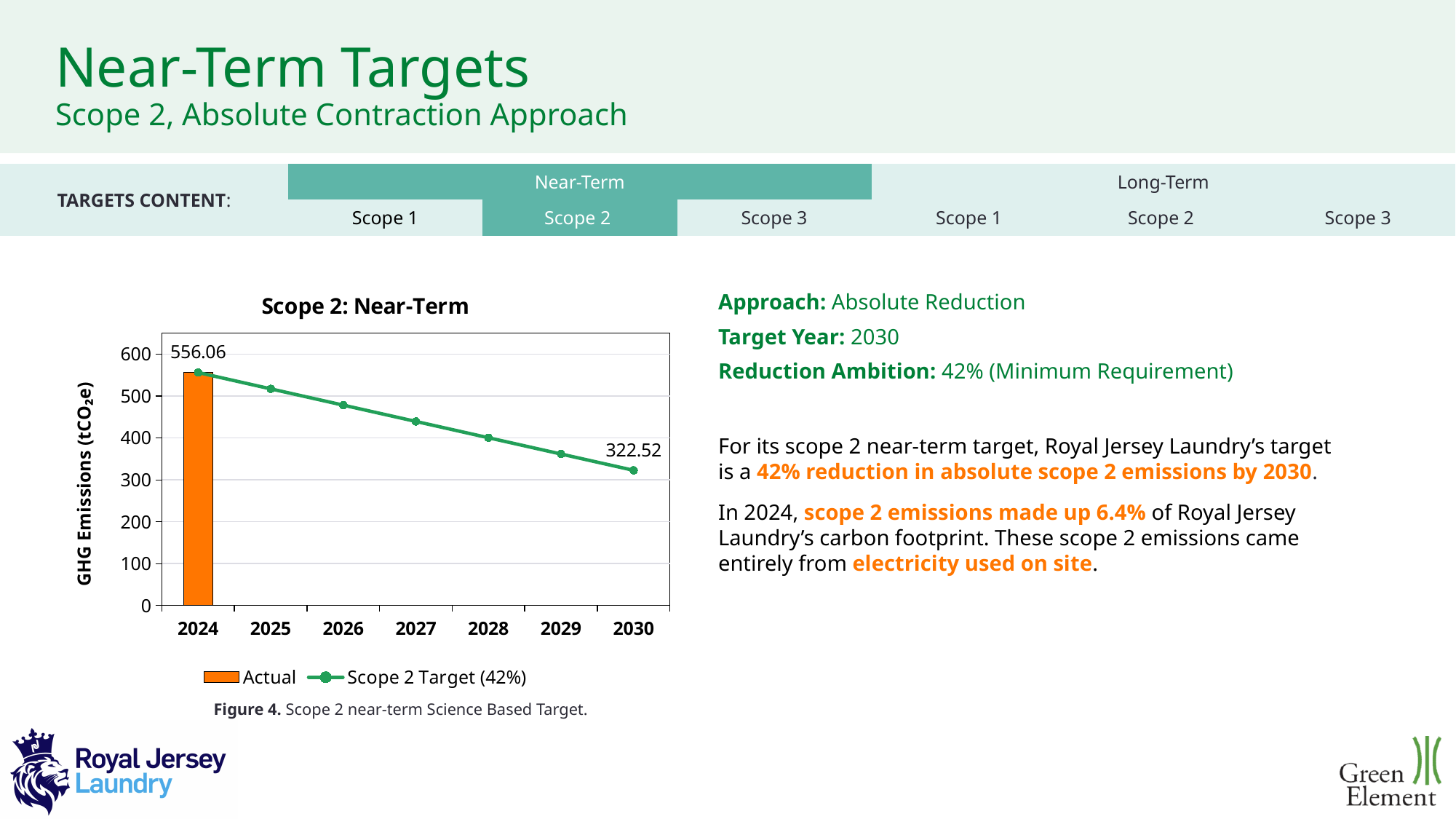
What is the Actual value for 2024? 556.06 What is the Scope 2 Target value for 2030? 322.52 What is the title of the chart? Scope 2: Near-Term Which year has the highest Scope 2 Target value? 2024 Is the Scope 2 Target value for 2027 greater or less than 400? greater How many years are shown on the x axis? 7 Which year has the lowest Scope 2 Target value? 2030 Is the Scope 2 Target value for 2029 greater or less than 400? less How many series does the legend list? 2 Does the Scope 2 Target line rise or fall from 2024 to 2030? fall What is the label of the y axis? GHG Emissions (tCO₂e) What is the difference between the 2024 value of 556.06 and the 2030 target of 322.52? 233.54